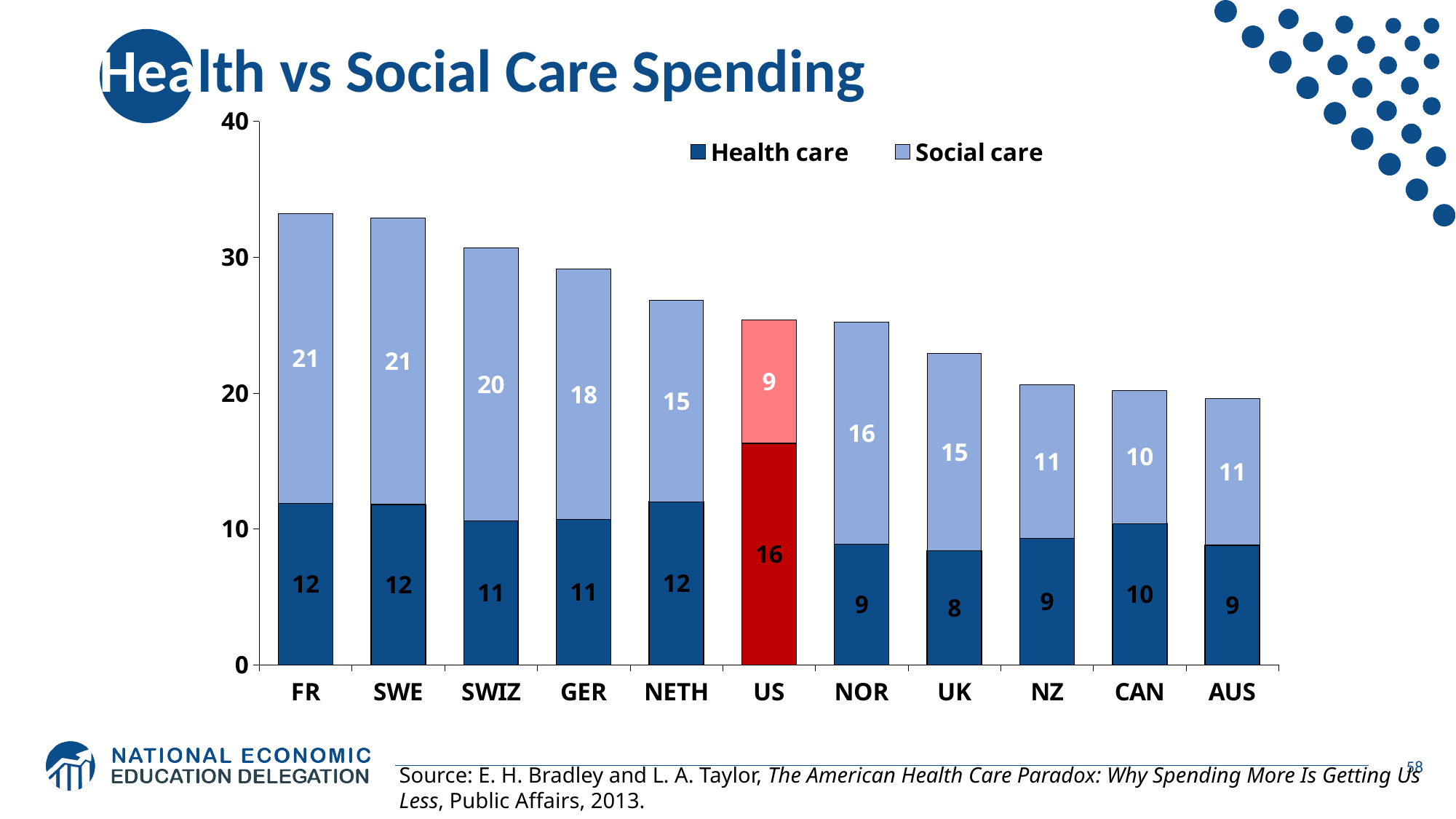
What is the difference between the Social care value for Norway (NOR) and the Social care value for the US? 7 What kind of chart is shown on the slide? Stacked bar chart Which country has the lowest Social care spending value? US What is the Health care spending value for the US? 16 Which country has the lowest Health care spending value? UK What is the total of the stacked bar for the UK? 23 Which country has the highest Health care spending value? US What is the Social care spending value for Germany (GER)? 18 How many series does the legend list? 2 How many countries are shown on the x axis? 11 Which is larger: the Health care value for the Netherlands (NETH) or the Health care value for Canada (CAN)? Netherlands (NETH) What is the total of the stacked bar for France (FR)? 33